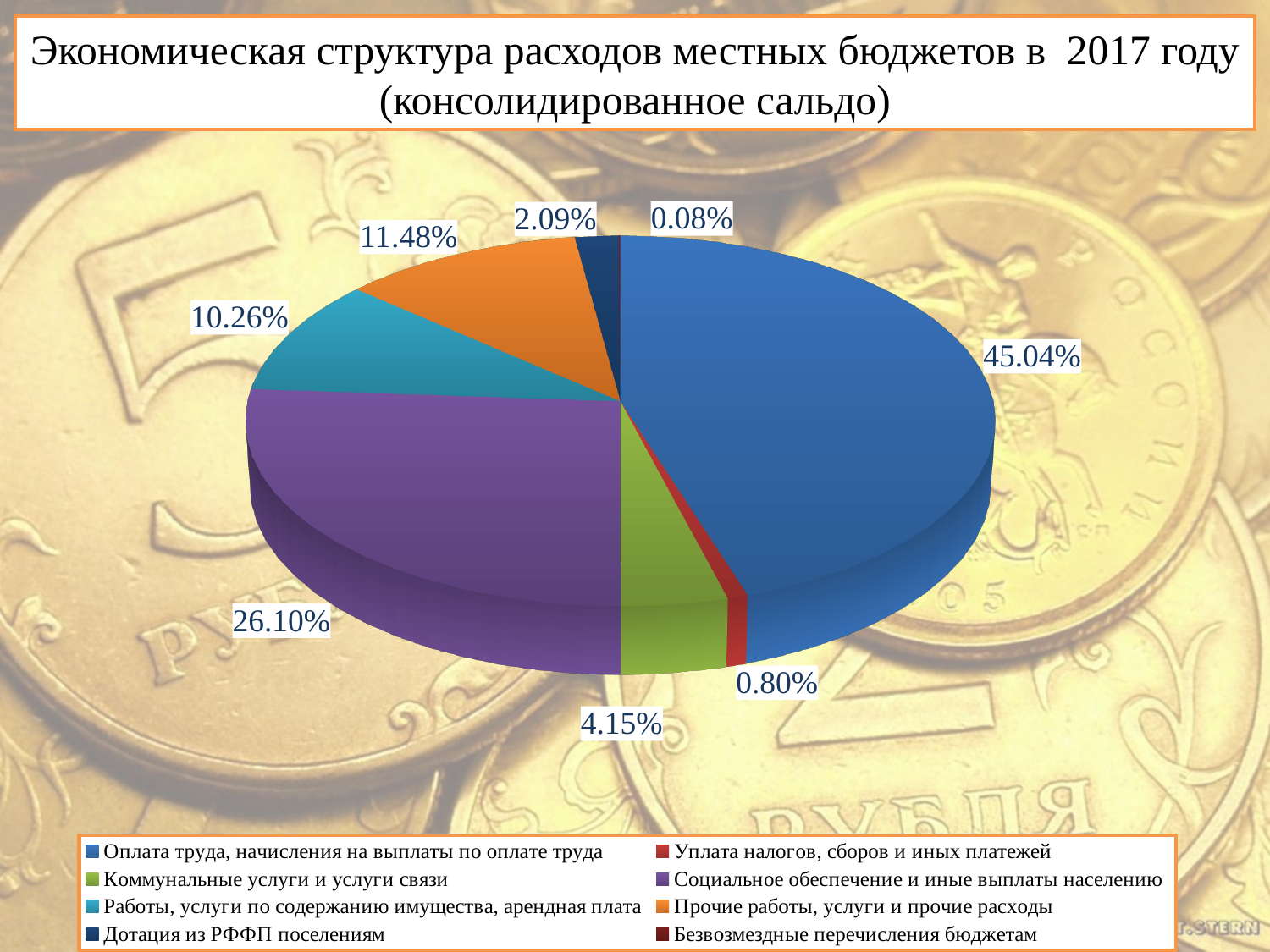
What share of expenditures is 'Социальное обеспечение и иные выплаты населению'? 26.10% What is the difference in percentage points between 'Оплата труда, начисления на выплаты по оплате труда' and 'Социальное обеспечение и иные выплаты населению'? 18.94 What colour is the slice for 'Социальное обеспечение и иные выплаты населению'? purple Which category has the largest share of the pie? Оплата труда, начисления на выплаты по оплате труда What share of expenditures is 'Коммунальные услуги и услуги связи'? 4.15% How many categories does the legend list? 8 What share of expenditures is 'Прочие работы, услуги и прочие расходы'? 11.48% What kind of chart is shown on the slide? pie chart Which is larger: 'Прочие работы, услуги и прочие расходы' or 'Работы, услуги по содержанию имущества, арендная плата'? Прочие работы, услуги и прочие расходы What share of expenditures is 'Дотация из РФФП поселениям'? 2.09% Which category has the smallest share of the pie? Безвозмездные перечисления бюджетам What share of expenditures is 'Оплата труда, начисления на выплаты по оплате труда'? 45.04%